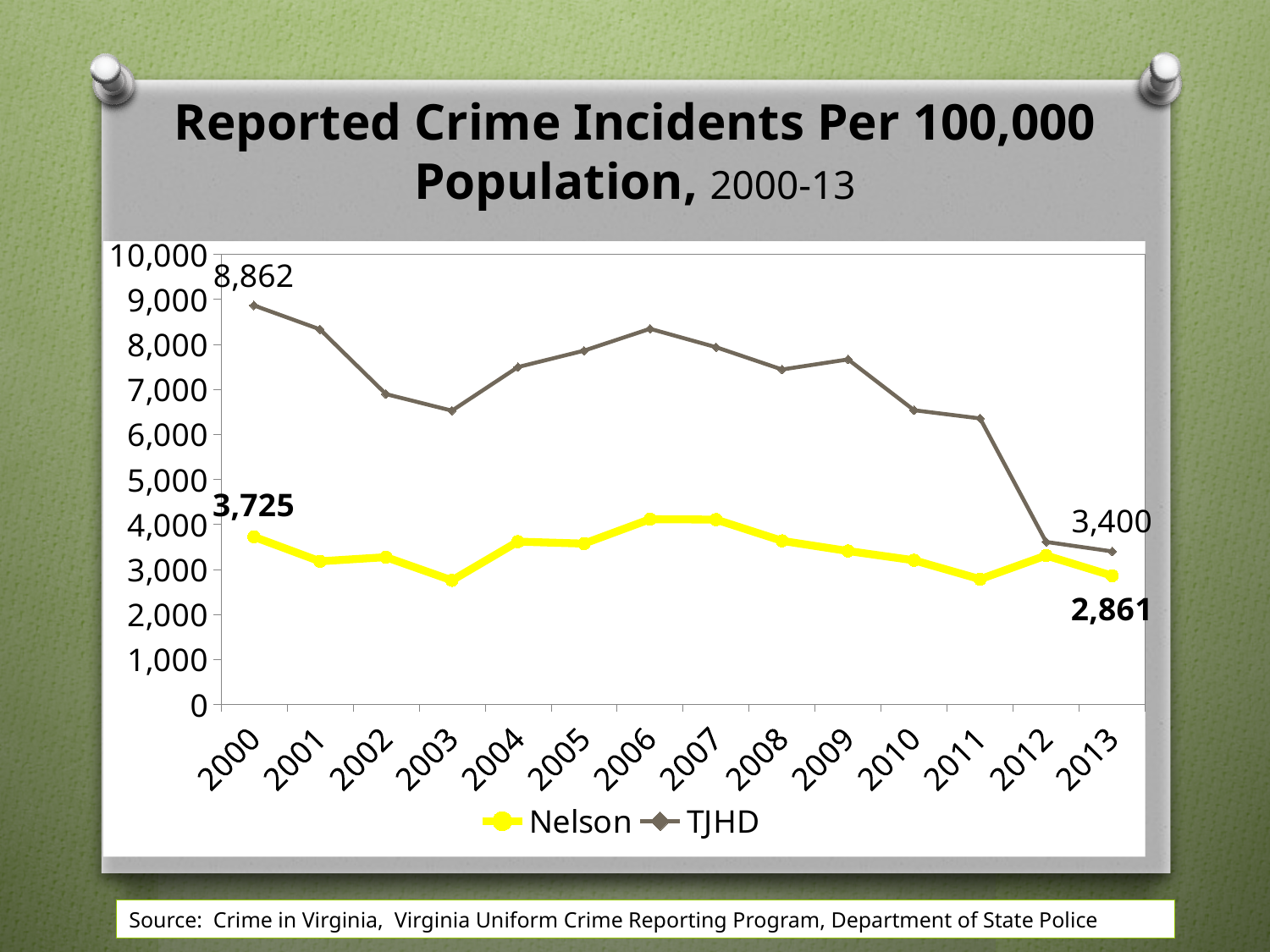
By how much did the TJHD value fall from 2000 to 2013? 5,462 What is the Nelson value for 2013? 2,861 What is the TJHD value for 2013? 3,400 What type of chart is shown on the slide? line chart How many years are plotted along the x axis? 14 Is the TJHD value for 2003 greater or less than 7,000? less What is the difference between the TJHD and Nelson values in 2000? 5,137 What is the Nelson value for 2000? 3,725 Which series has the higher value in 2006, Nelson or TJHD? TJHD Overall, does the TJHD series rise or fall from 2000 to 2013? fall How many series does the legend list? 2 What is the TJHD value for 2000? 8,862